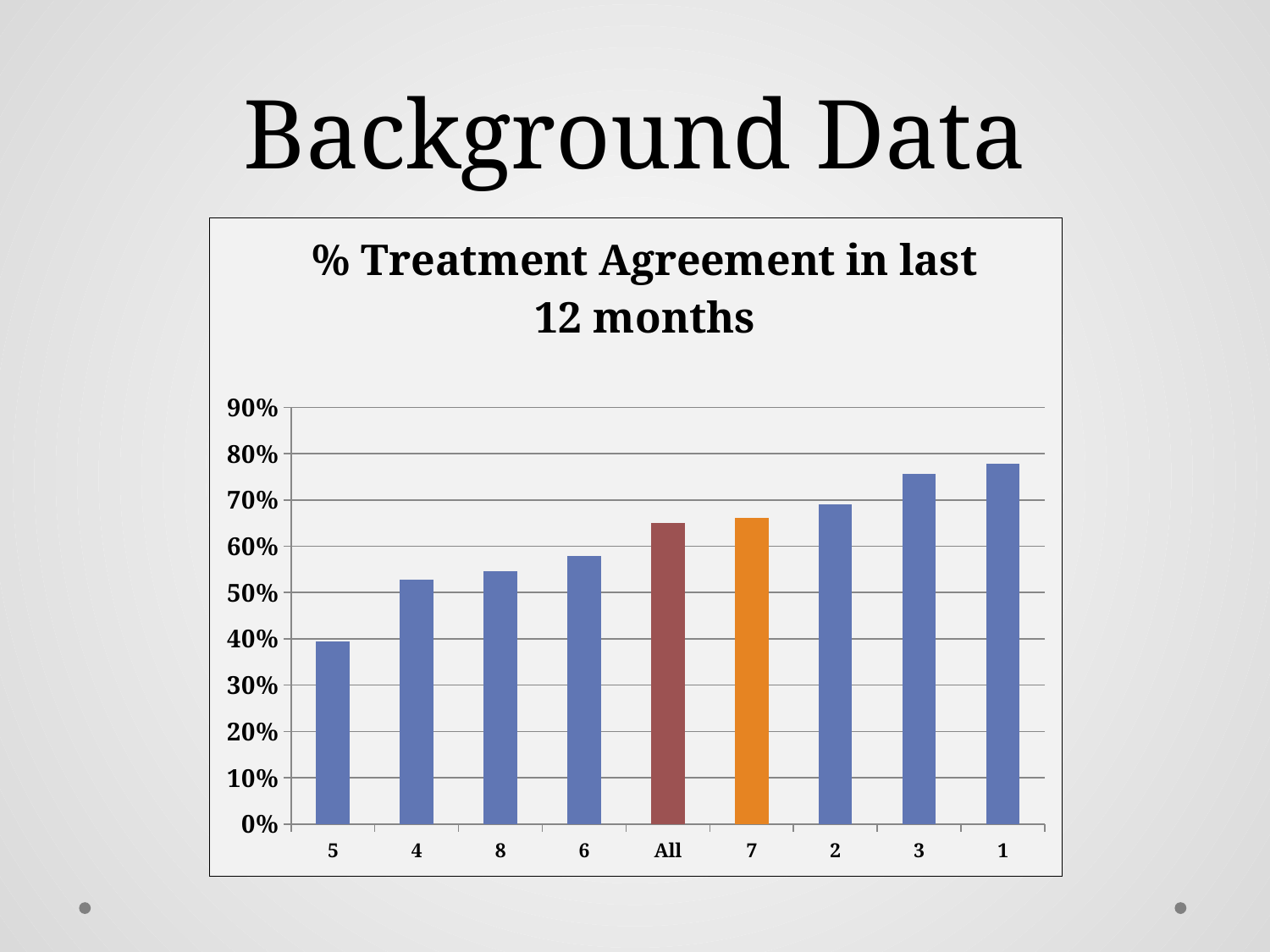
Which category has the highest % treatment agreement? 1 Which has a larger value, category 2 or category 4? 2 Is the value for category 6 greater or less than 50%? greater What kind of chart is shown on the slide? bar chart What is the title of the chart? % Treatment Agreement in last 12 months How many categories are shown on the x axis of the chart? 9 Is the value for category 1 greater or less than 70%? greater Is the value for category 3 greater or less than 80%? less Which category has the lowest % treatment agreement? 5 Do the values generally rise or fall moving from left to right along the x axis? rise Which category's bar is coloured orange? 7